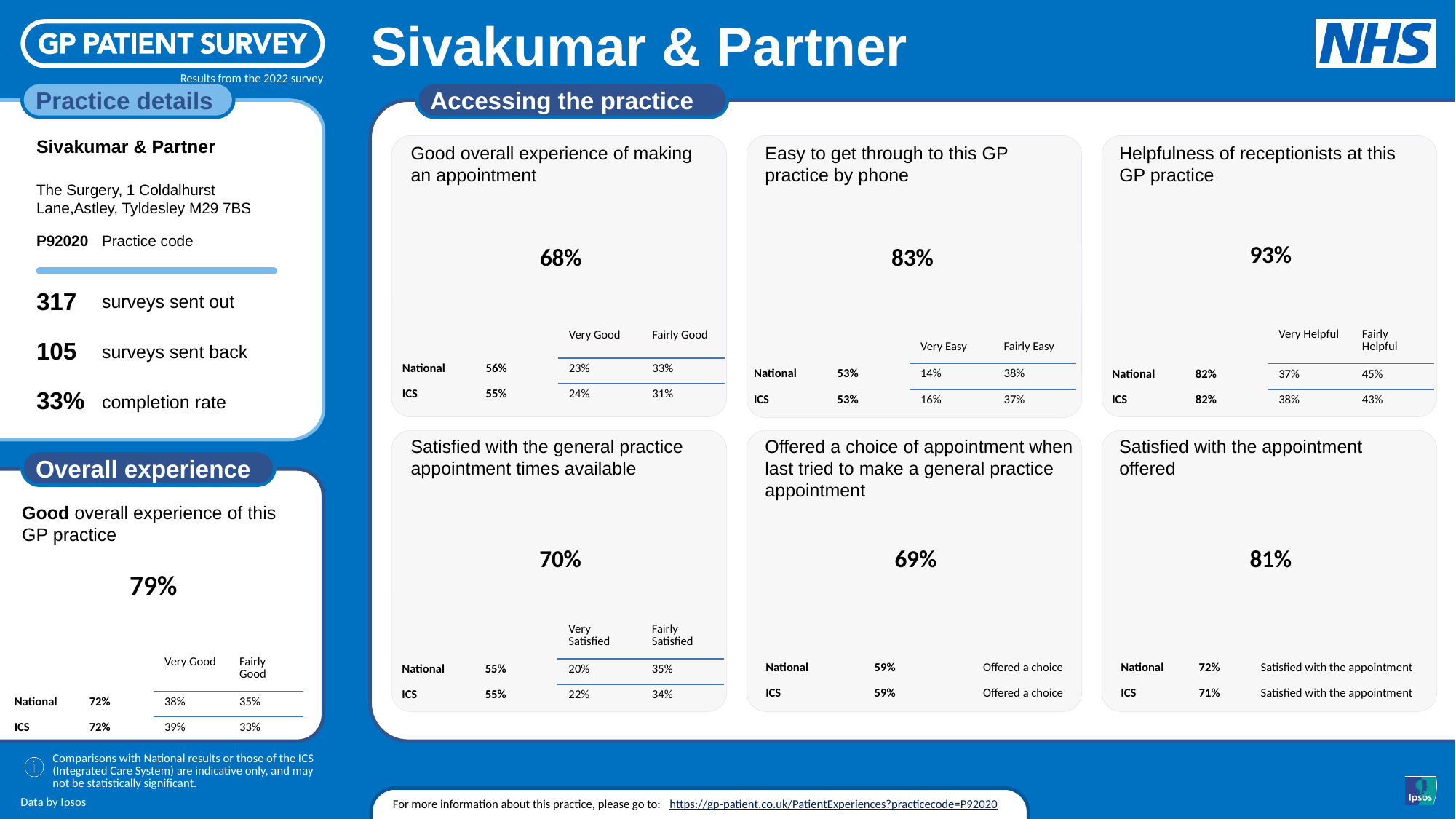
In the 'Easy to get through to this GP practice by phone' panel, what is the difference between the practice's 83% and the National 53%? 30 percentage points In the 'Helpfulness of receptionists at this GP practice' panel, what is the ICS 'Very Helpful' percentage? 38% In the 'Offered a choice of appointment' panel, what is the ICS percentage? 59% In the 'Easy to get through to this GP practice by phone' panel, what is the National percentage? 53% Among the six 'Accessing the practice' panels, which has the lowest practice headline percentage? Good overall experience of making an appointment In the 'Overall experience' panel, what is the total of the National 'Very Good' and 'Fairly Good' percentages? 73% In the 'Satisfied with the general practice appointment times available' panel, what is the National 'Fairly Satisfied' percentage? 35% How many panels are shown under the 'Accessing the practice' heading? 6 In the 'Overall experience' panel, what is the practice's 'Good overall experience of this GP practice' percentage? 79% Among the six 'Accessing the practice' panels, which has the highest practice headline percentage? Helpfulness of receptionists at this GP practice In the 'Satisfied with the appointment offered' panel, which is larger: the National percentage or the ICS percentage? National In the 'Good overall experience of making an appointment' panel, what is the practice's headline percentage? 68%